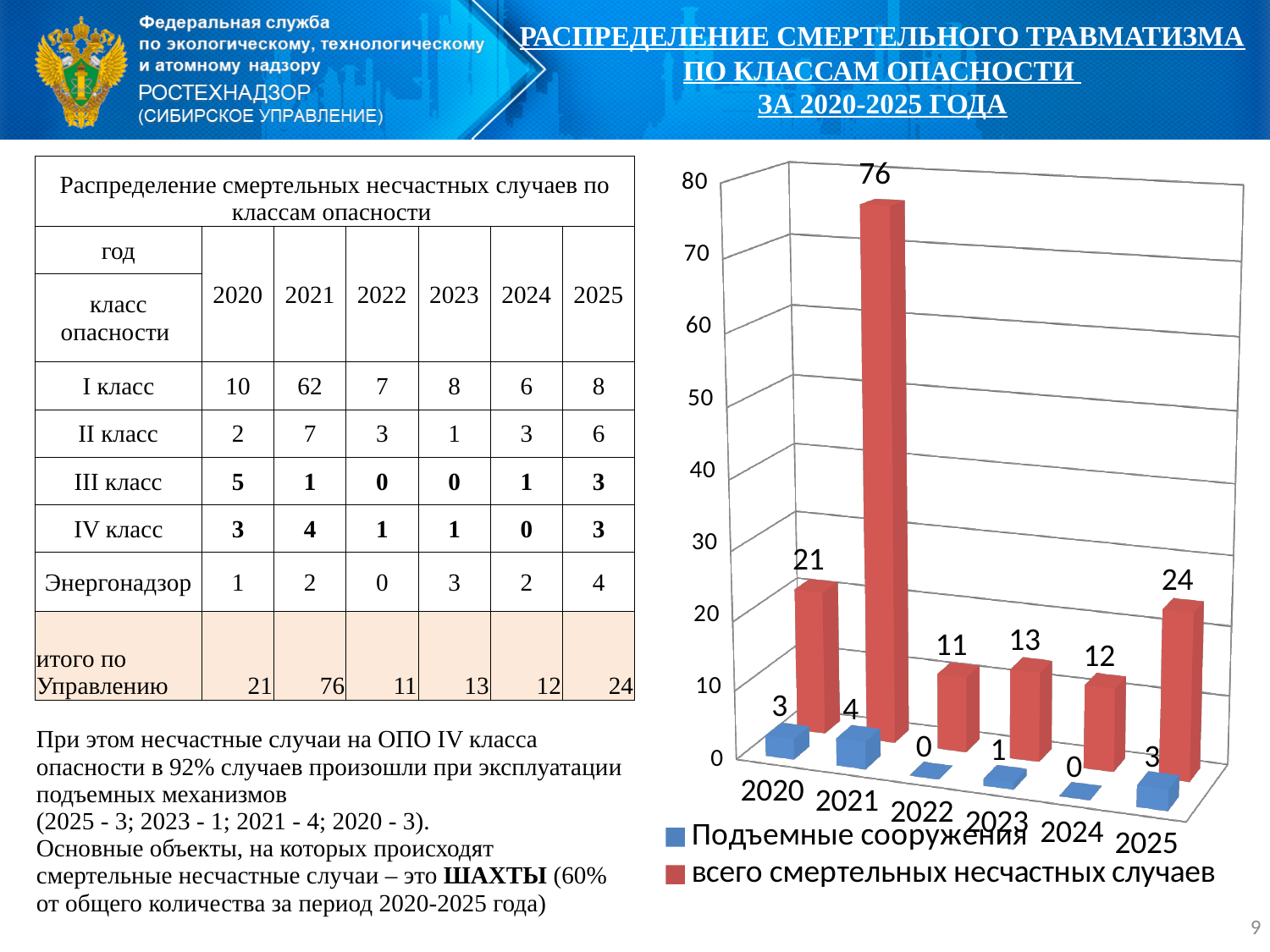
Which year has the highest value for 'всего смертельных несчастных случаев'? 2021 What is the value for 'Подъемные сооружения' in 2023? 1 What type of chart is shown on the slide? bar chart Which year has the lowest value for 'всего смертельных несчастных случаев'? 2022 What is the difference between the 'всего смертельных несчастных случаев' values for 2021 and 2020? 55 Is the value for 'всего смертельных несчастных случаев' in 2025 greater or less than 20? greater What is the value for 'всего смертельных несчастных случаев' in 2025? 24 Which series is shown in red in the chart? всего смертельных несчастных случаев What is the value for 'всего смертельных несчастных случаев' in 2021? 76 How many series does the chart legend list? 2 Which is larger: the 'всего смертельных несчастных случаев' value for 2023 or for 2024? 2023 How many years are shown on the x axis of the chart? 6